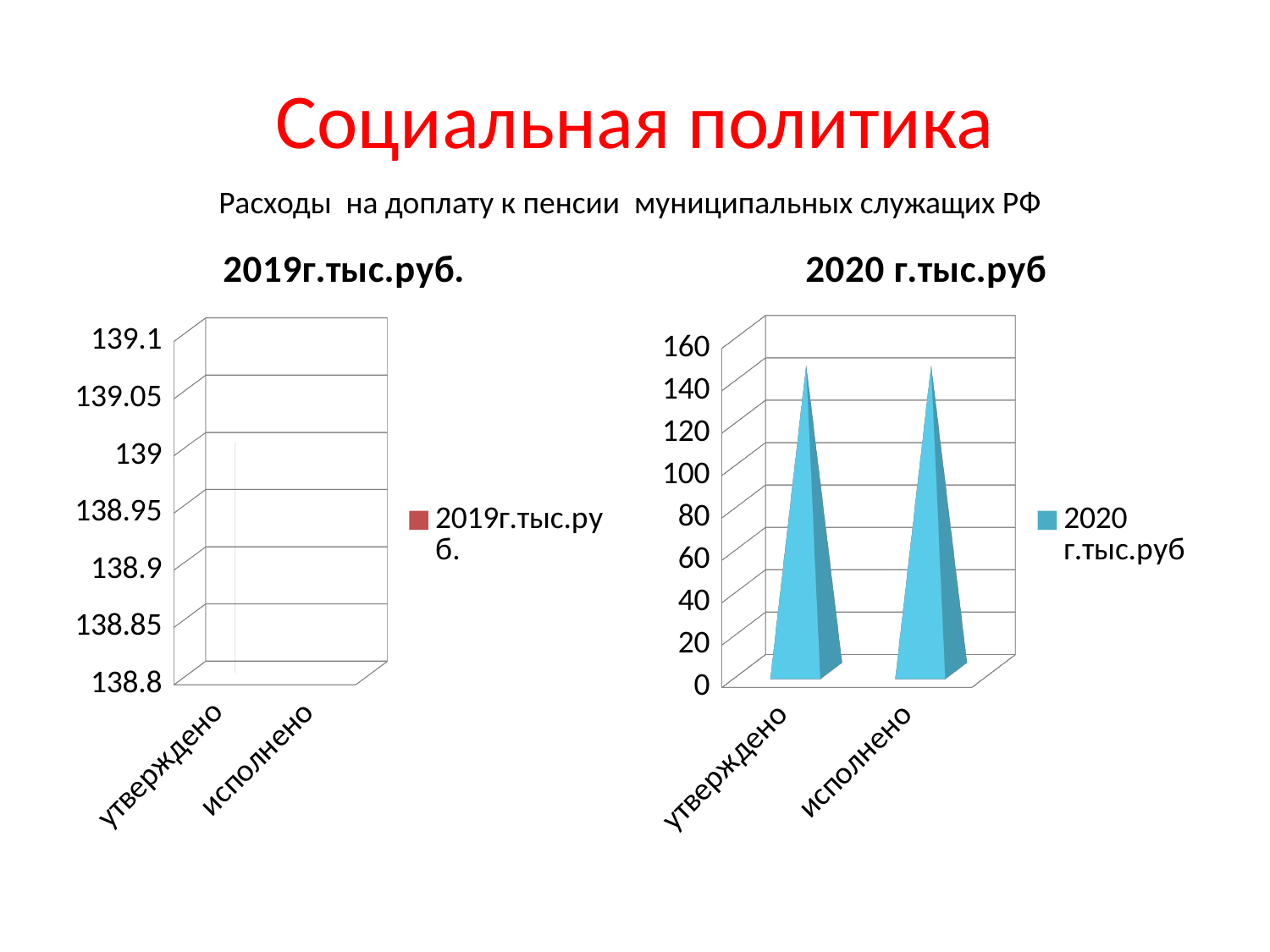
How many series does the legend of the right-hand chart "2020 г.тыс.руб" list? 1 What is the legend entry of the right-hand chart? 2020 г.тыс.руб What is the title of the left-hand chart? 2019г.тыс.руб. What kind of chart is the right-hand chart titled "2020 г.тыс.руб"? bar chart In the right-hand chart "2020 г.тыс.руб", is the value for утверждено greater or less than 120? greater What are the two category labels on the x axis of the left-hand chart "2019г.тыс.руб."? утверждено, исполнено In the right-hand chart "2020 г.тыс.руб", is the value for утверждено greater or less than 160? less How many series does the legend of the left-hand chart "2019г.тыс.руб." list? 1 In the right-hand chart "2020 г.тыс.руб", is the value for исполнено greater or less than 100? greater How many categories are shown on the x axis of the right-hand chart "2020 г.тыс.руб"? 2